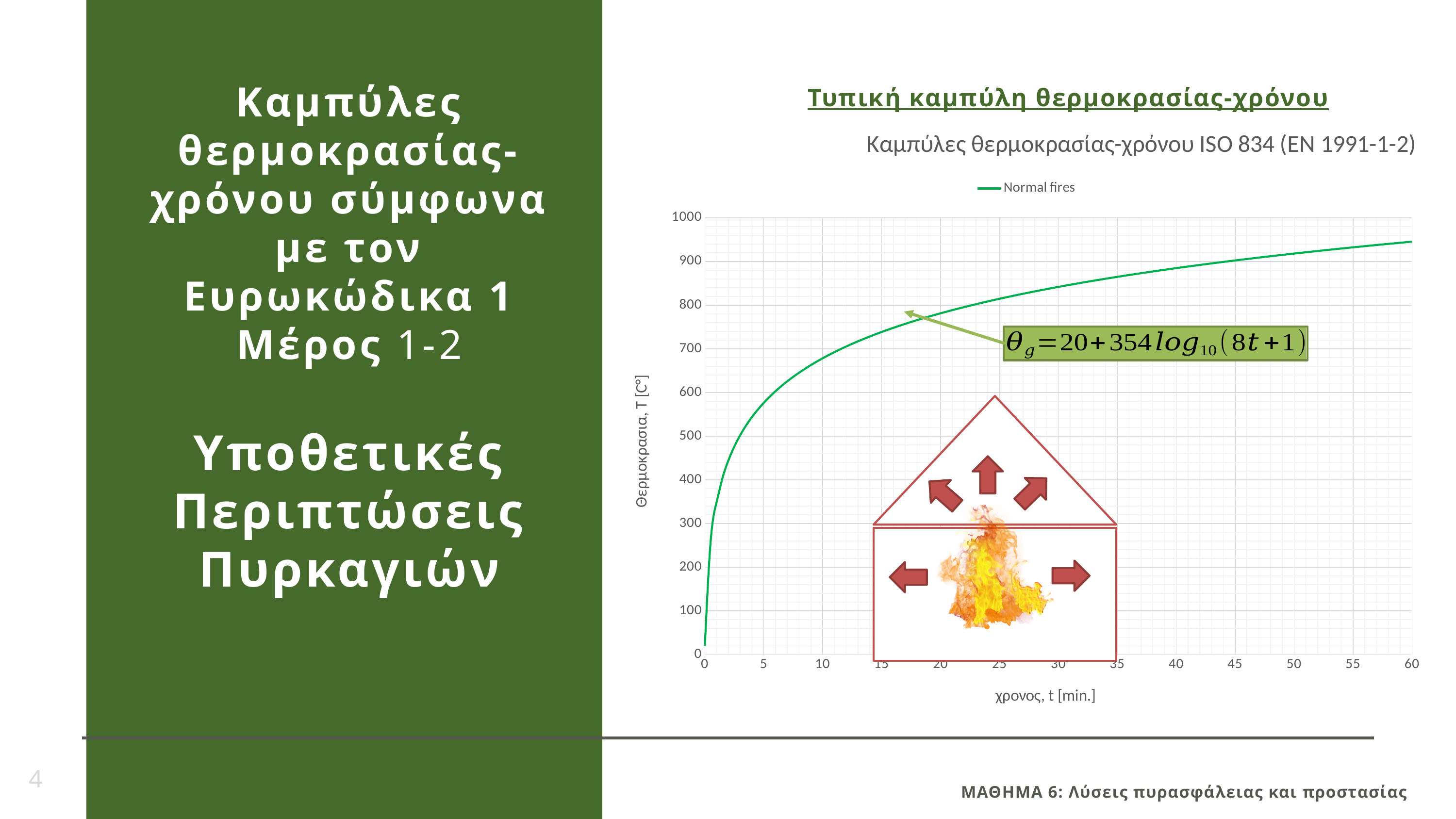
At which time on the x axis does the Normal fires curve reach its highest temperature? 60 How many series does the chart legend list? 1 Does the temperature rise or fall as time increases along the x axis? rise Is the temperature of the Normal fires curve at 5 minutes greater or less than 500? greater What is the title of the chart? Καμπύλες θερμοκρασίας-χρόνου ISO 834 (EN 1991-1-2) What is the name of the series shown in the chart legend? Normal fires Is the temperature of the Normal fires curve at 60 minutes greater or less than 900? greater Is the temperature of the Normal fires curve at 30 minutes greater or less than 800? greater What kind of chart is shown on the slide? line chart